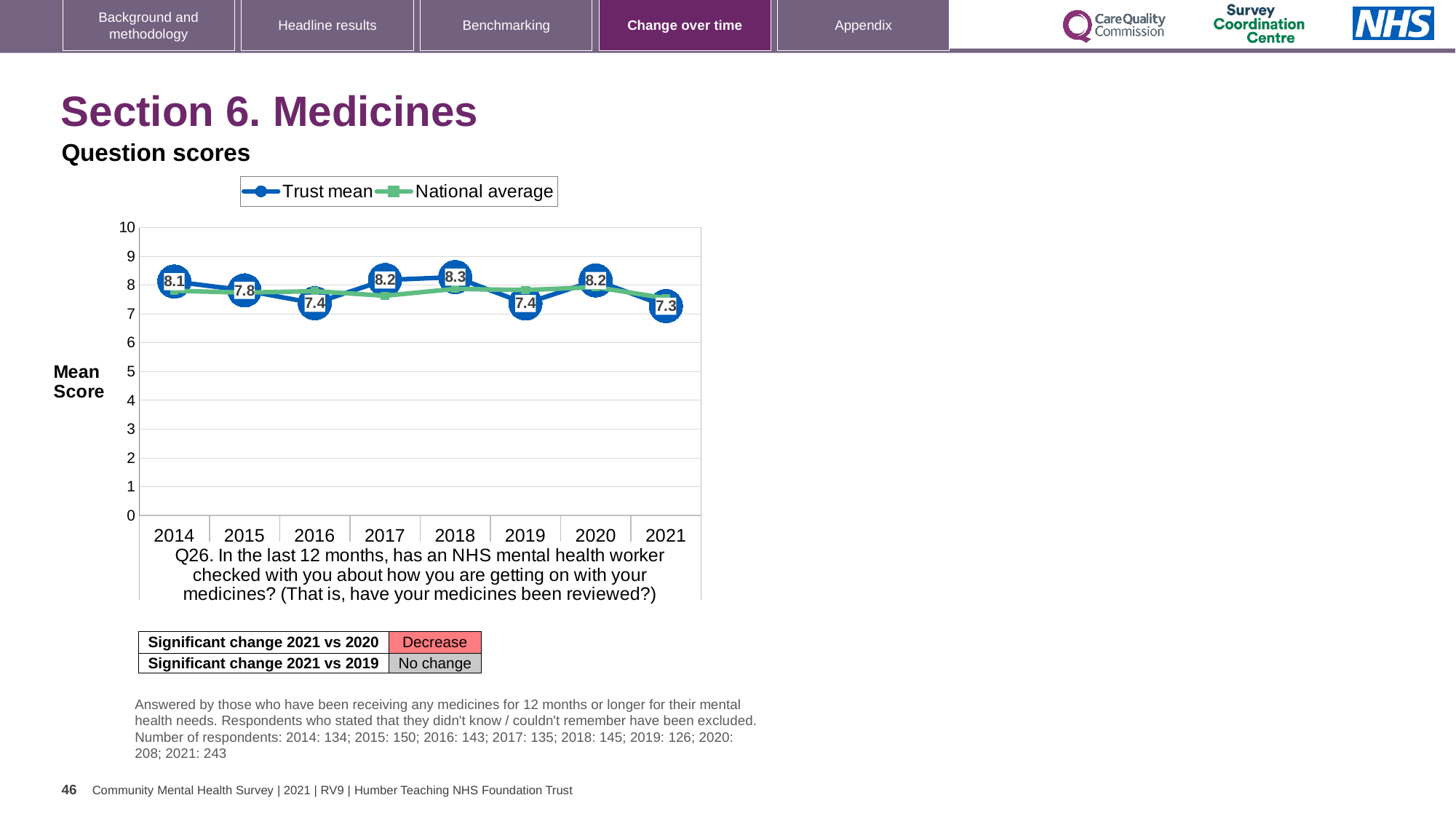
Is the National average score for 2021 greater or less than 7? greater What kind of chart is shown on the slide? Line chart What is the Trust mean score for 2021? 7.3 What is the Trust mean score for 2018? 8.3 How many years are shown on the x axis of the chart? 8 Which is larger, the Trust mean score for 2017 or for 2019? 2017 How many series does the chart legend list? 2 In which year is the Trust mean score lowest? 2021 What is the Trust mean score for 2014? 8.1 What is the difference between the Trust mean scores for 2020 and 2021? 0.9 Did the Trust mean score rise or fall from 2020 to 2021? Fall In which year is the Trust mean score highest? 2018